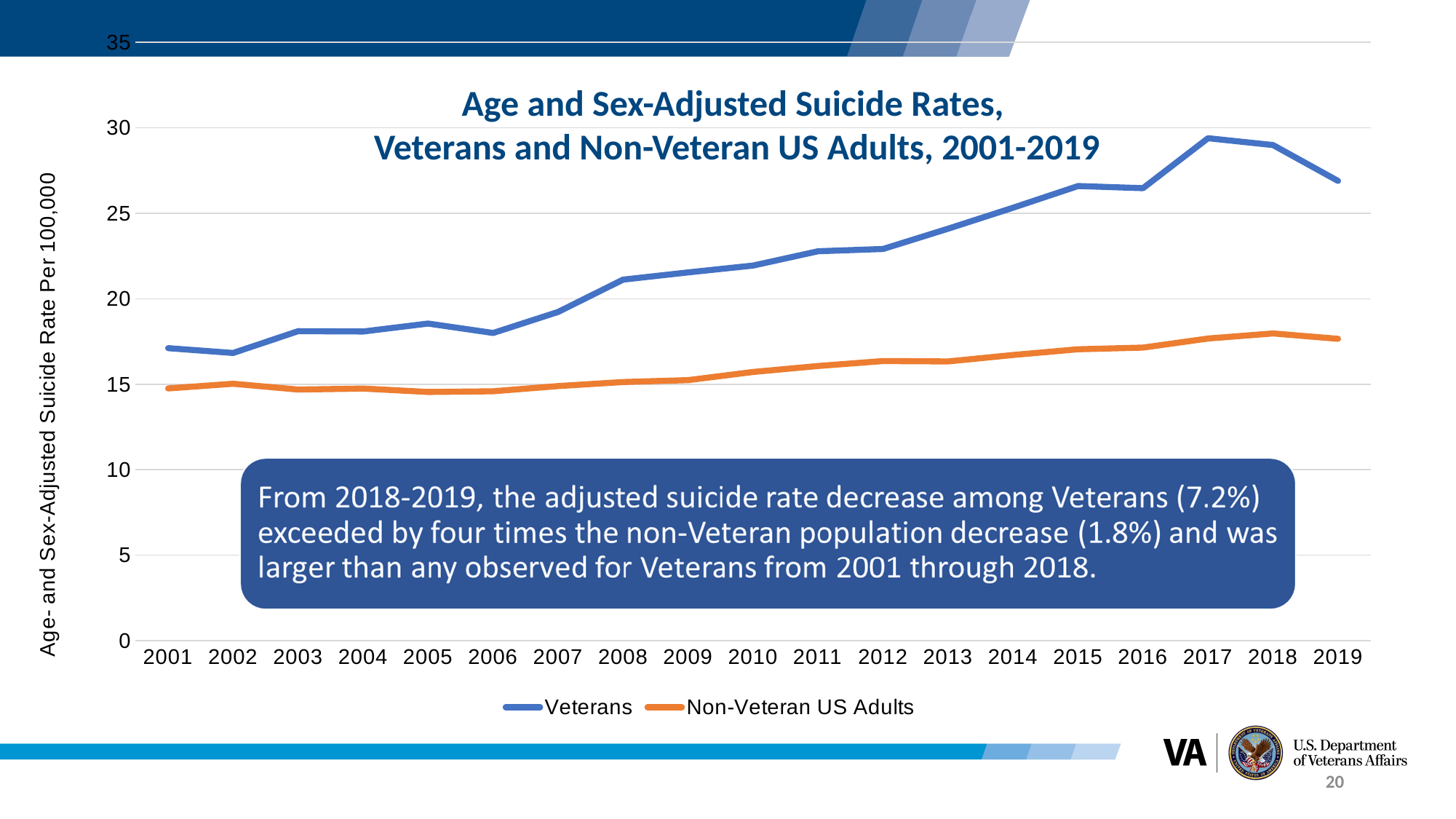
How many series does the legend list? 2 Is the value for Non-Veteran US Adults in 2012 greater or less than 20? less Is the value for Veterans in 2017 greater or less than 25? greater Which series has the larger value in 2019, Veterans or Non-Veteran US Adults? Veterans Does the Veterans series generally rise or fall from 2001 to 2017? Rise In which year does the Veterans series reach its highest value? 2017 How many years are plotted along the x axis? 19 What colour is the line for Non-Veteran US Adults? Orange What kind of chart is shown on the slide? Line chart Is the value for Veterans in 2006 greater or less than 20? less What is the title of the chart? Age and Sex-Adjusted Suicide Rates, Veterans and Non-Veteran US Adults, 2001-2019